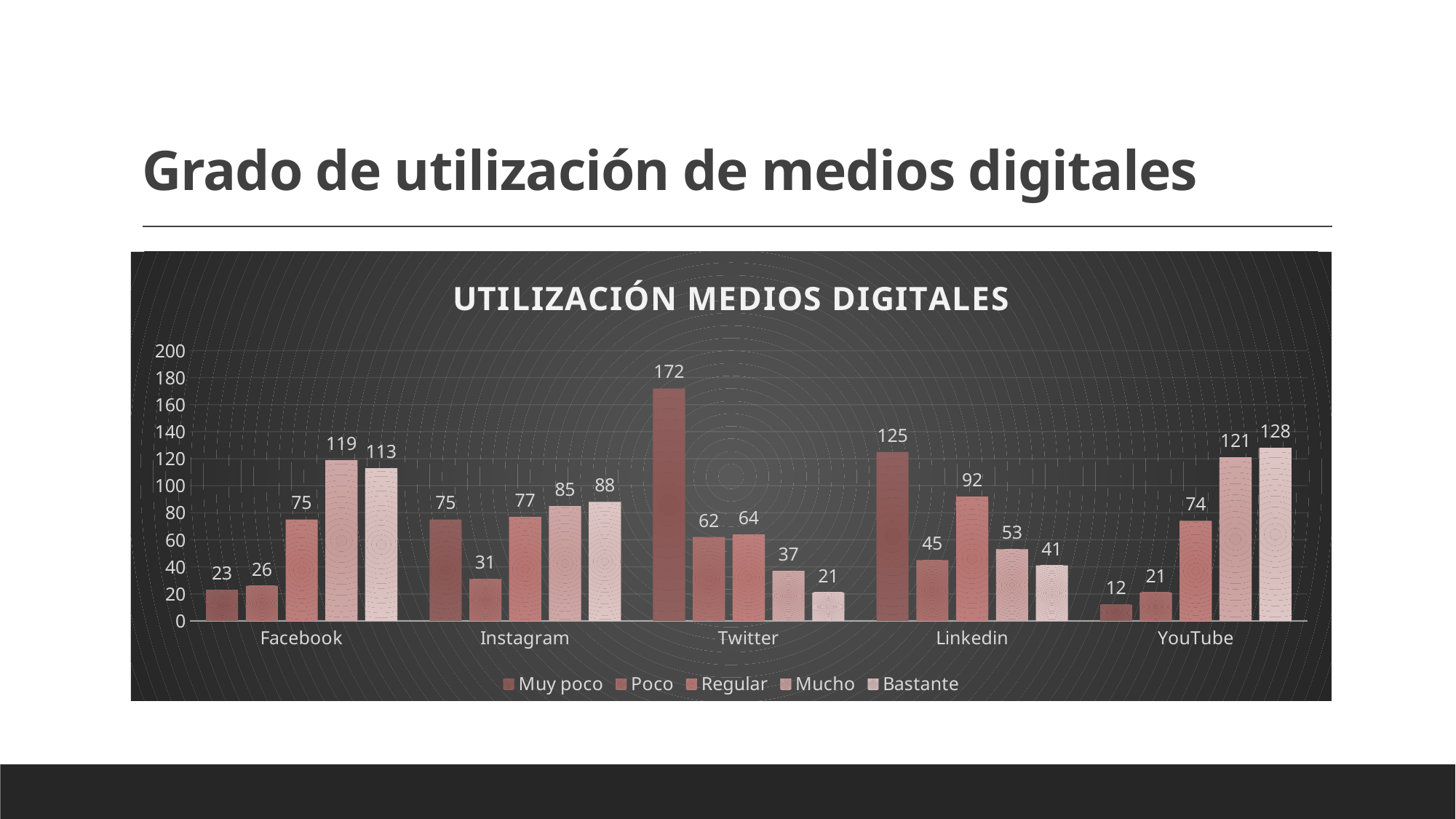
Which category has the lowest value in the "Bastante" series? Twitter What kind of chart is shown on the slide? Bar chart What is the value of the "Bastante" series for YouTube? 128 What is the value of the "Muy poco" series for Twitter? 172 What is the title of the chart? UTILIZACIÓN MEDIOS DIGITALES Which category has the highest value in the "Muy poco" series? Twitter What is the value of the "Mucho" series for Facebook? 119 What is the difference between the "Mucho" and "Bastante" values for YouTube? 7 Which is larger for Instagram: the "Regular" value or the "Poco" value? Regular How many series does the legend list? 5 How many categories are shown on the x axis? 5 What is the value of the "Poco" series for Linkedin? 45